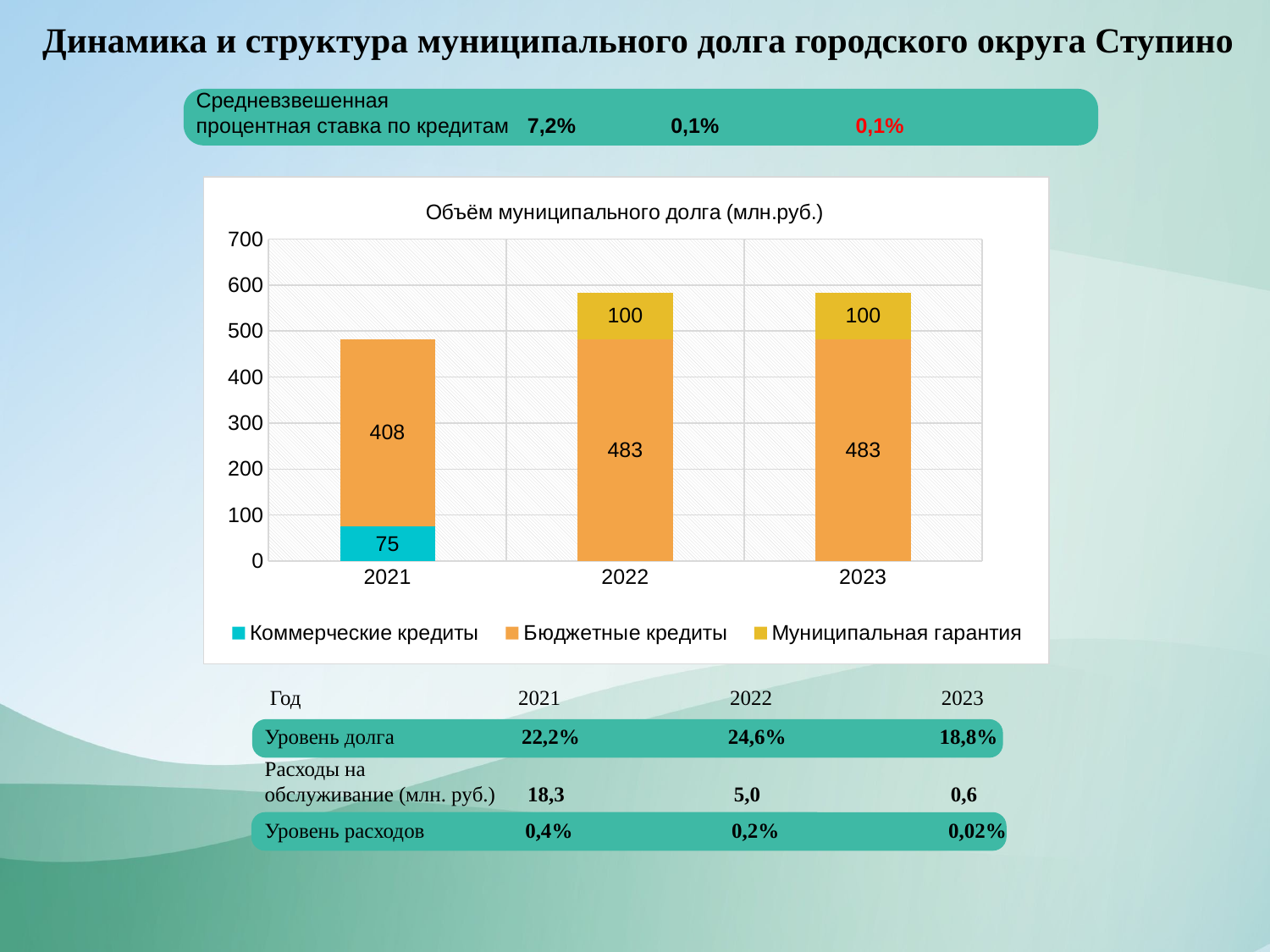
What is the title of the chart? Объём муниципального долга (млн.руб.) What kind of chart is shown? Stacked bar chart How many years are shown on the x axis? 3 What is the total of the stacked bar for 2022? 583 What is the difference between Бюджетные кредиты in 2022 and in 2021? 75 What is the value of Бюджетные кредиты for 2022? 483 How many series does the legend list? 3 What is the total of the stacked bar for 2021? 483 What is the value of Бюджетные кредиты for 2021? 408 What is the value of Муниципальная гарантия for 2023? 100 What is the value of Коммерческие кредиты for 2021? 75 Which is larger: Бюджетные кредиты in 2021 or Бюджетные кредиты in 2023? 2023